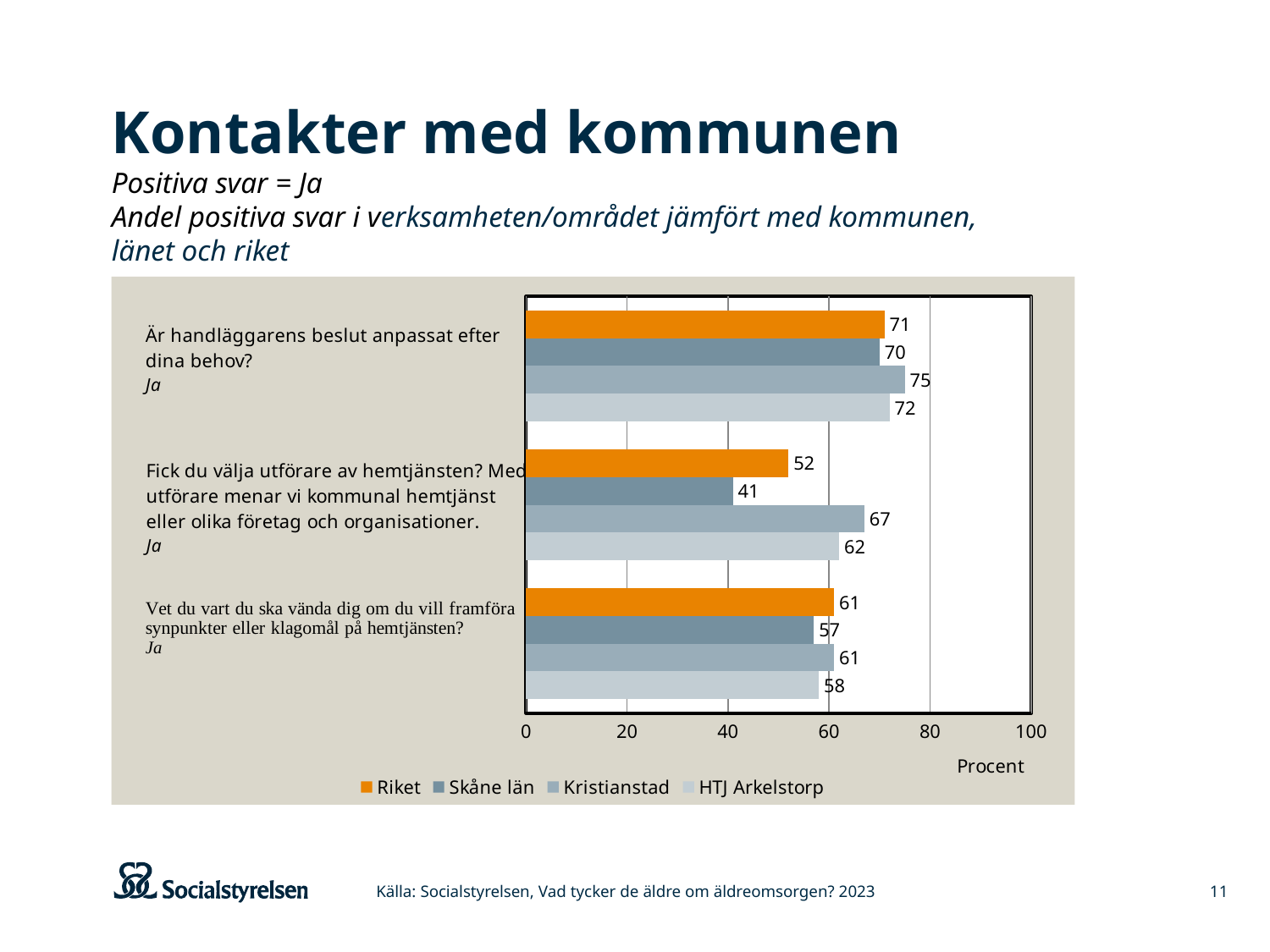
Which series has the lowest value on the question "Är handläggarens beslut anpassat efter dina behov?"? Skåne län How many questions (categories) are shown on the chart? 3 Which series has the highest value on the question "Fick du välja utförare av hemtjänsten?"? Kristianstad Is the value for Skåne län on the question "Fick du välja utförare av hemtjänsten?" greater or less than 60? less What is the difference between Kristianstad and Skåne län on the question "Fick du välja utförare av hemtjänsten?"? 26 What is the value for HTJ Arkelstorp on the question "Vet du vart du ska vända dig om du vill framföra synpunkter eller klagomål på hemtjänsten?"? 58 Which is larger on the question "Vet du vart du ska vända dig om du vill framföra synpunkter eller klagomål på hemtjänsten?": Riket or Skåne län? Riket What kind of chart is shown on the slide? Bar chart What is the value for Kristianstad on the question "Är handläggarens beslut anpassat efter dina behov?"? 75 How many series does the legend list? 4 What is the value for Skåne län on the question "Fick du välja utförare av hemtjänsten?"? 41 What is the value for Riket on the question "Fick du välja utförare av hemtjänsten?"? 52